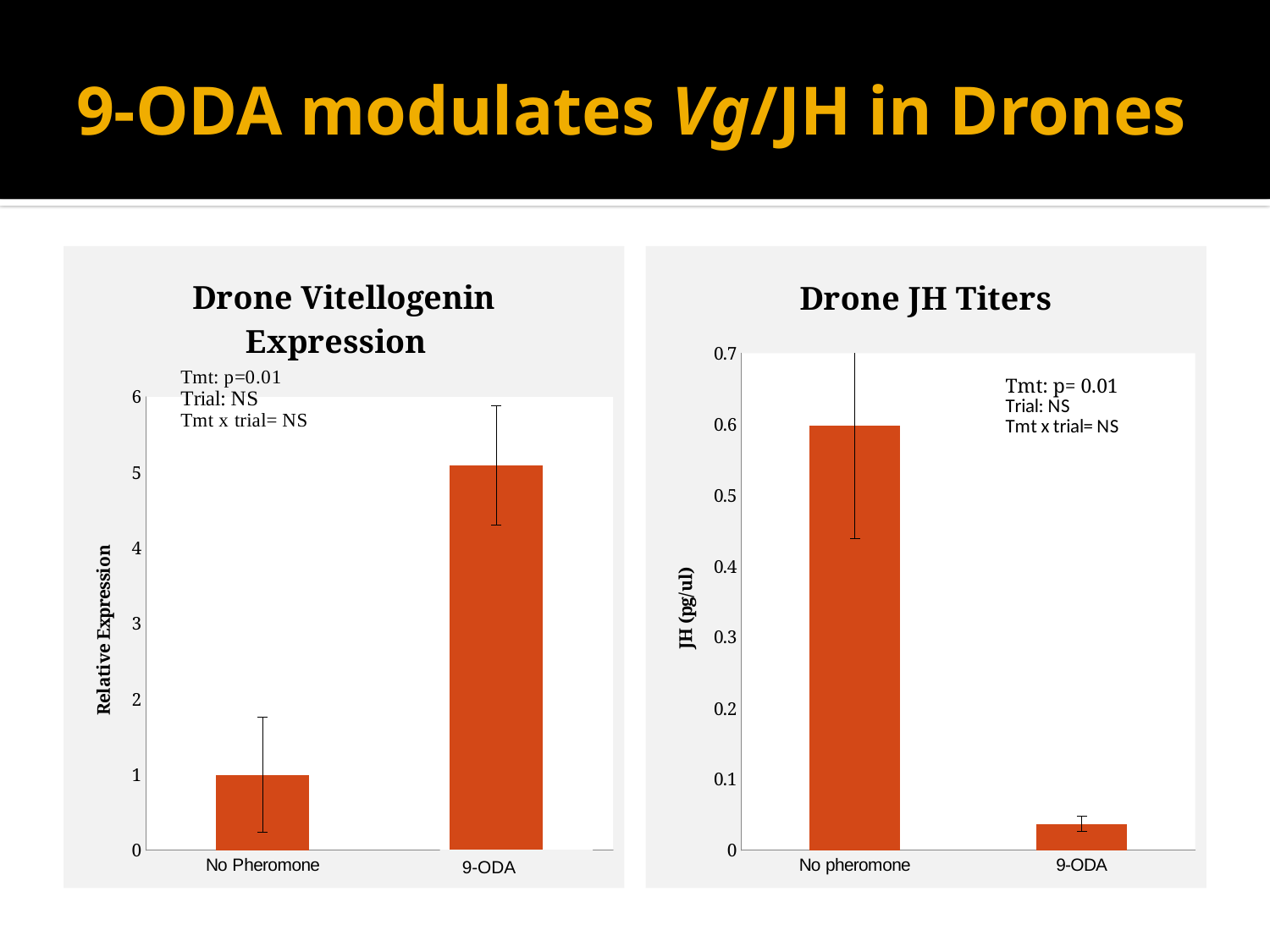
What is the y-axis label of the Drone Vitellogenin Expression chart? Relative Expression In the Drone Vitellogenin Expression chart, is the value for No Pheromone greater or less than 2? less In the Drone JH Titers chart, which category has the highest value? No pheromone In the Drone JH Titers chart, is the value for No pheromone greater or less than 0.5? greater In the Drone Vitellogenin Expression chart, how many categories are plotted? 2 In the Drone Vitellogenin Expression chart, is the value for 9-ODA greater or less than 4? greater In the Drone Vitellogenin Expression chart, which category has the lowest value? No Pheromone In the Drone Vitellogenin Expression chart, which category has the highest value? 9-ODA What kind of chart is the Drone JH Titers chart? bar chart What is the y-axis label of the Drone JH Titers chart? JH (pg/ul) In the Drone JH Titers chart, which is larger, the value for No pheromone or the value for 9-ODA? No pheromone